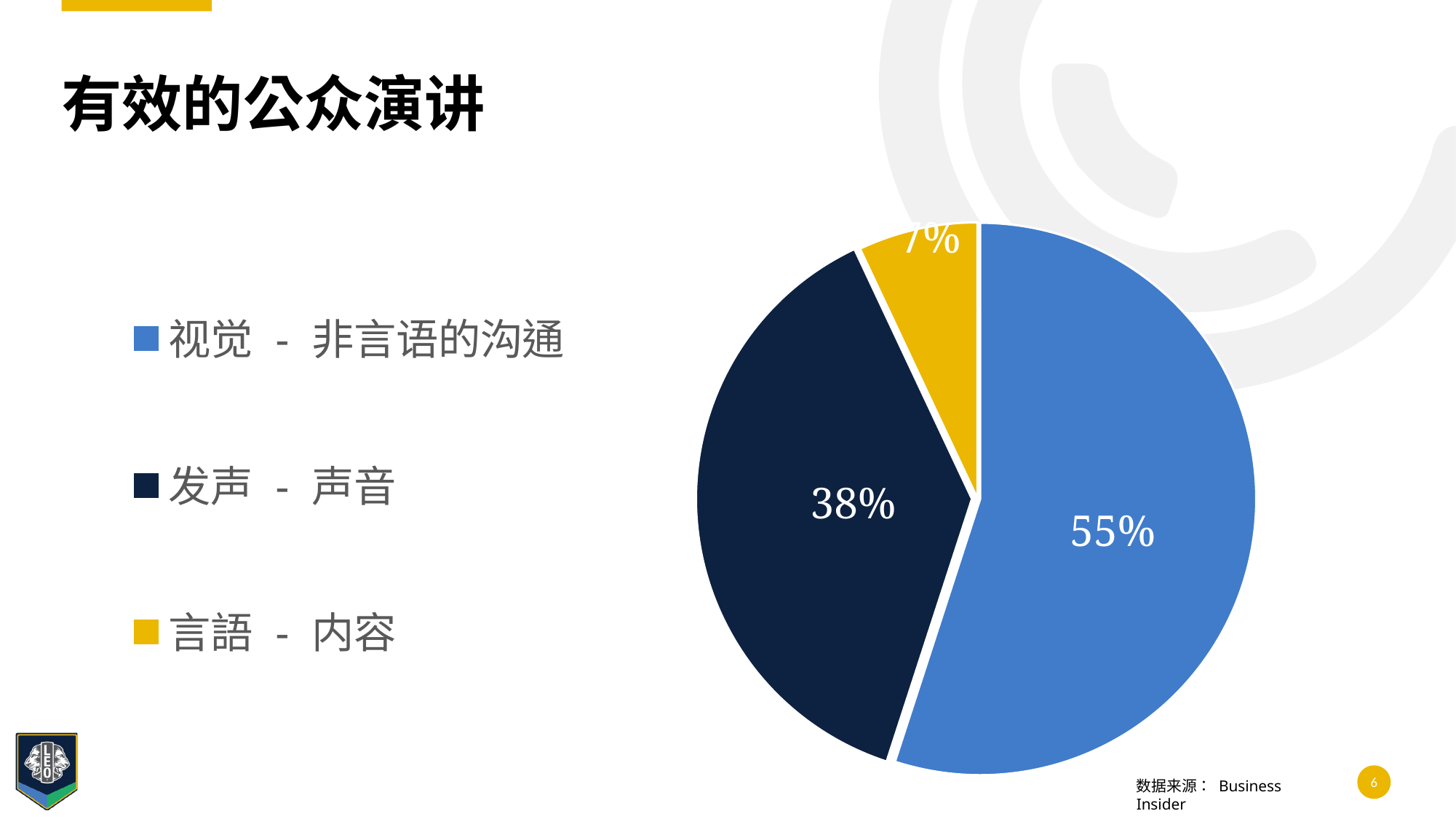
How many slices does the pie chart have? 3 What percentage is shown for 视觉 - 非言语的沟通? 55% What percentage is shown for 言語 - 内容? 7% What is the title of the slide containing the pie chart? 有效的公众演讲 What is the difference between the 视觉 - 非言语的沟通 slice and the 发声 - 声音 slice? 17% What kind of chart is shown on the slide? pie chart Which category has the smallest slice of the pie? 言語 - 内容 How many entries does the legend list? 3 What percentage is shown for 发声 - 声音? 38% What colour is the slice for 言語 - 内容? yellow Which category has the largest slice of the pie? 视觉 - 非言语的沟通 Which is larger, the 发声 - 声音 slice or the 言語 - 内容 slice? 发声 - 声音